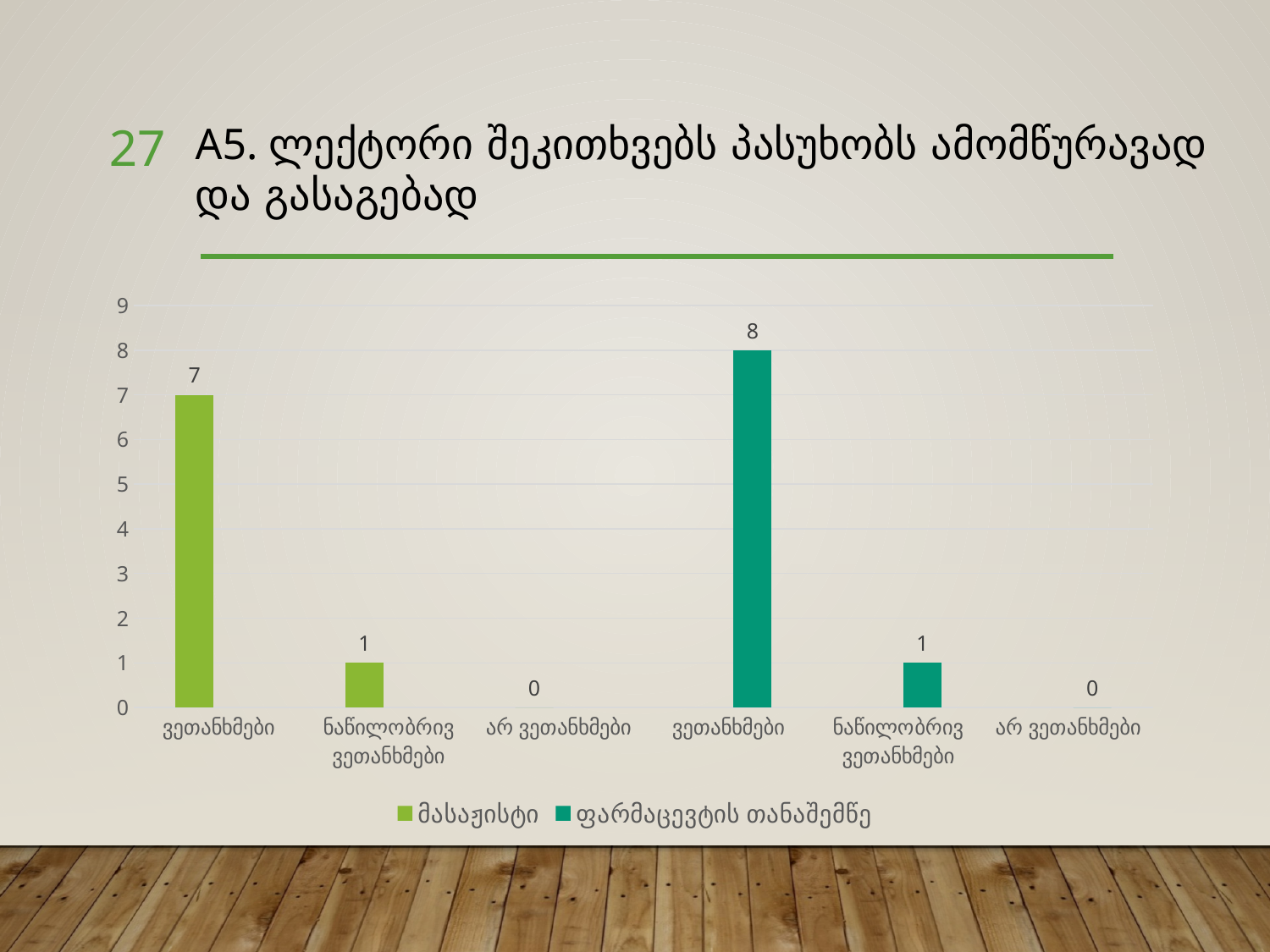
What is the value for ვეთანხმები in the ფარმაცევტის თანაშემწე series? 8 Is the ვეთანხმები value for მასაჟისტი greater or less than 5? greater Which bar has the highest value on the chart? ვეთანხმები (ფარმაცევტის თანაშემწე) How many category labels are shown along the x axis? 6 What is the value for ვეთანხმები in the მასაჟისტი series? 7 What is the value for ნაწილობრივ ვეთანხმები in the მასაჟისტი series? 1 What kind of chart is shown on the slide? bar chart What is the difference between the ვეთანხმები values for ფარმაცევტის თანაშემწე and მასაჟისტი? 1 Which is larger: the ვეთანხმები value for მასაჟისტი or for ფარმაცევტის თანაშემწე? ფარმაცევტის თანაშემწე What is the value for არ ვეთანხმები in the ფარმაცევტის თანაშემწე series? 0 What is the total of the three values in the მასაჟისტი series? 8 How many series does the legend list? 2